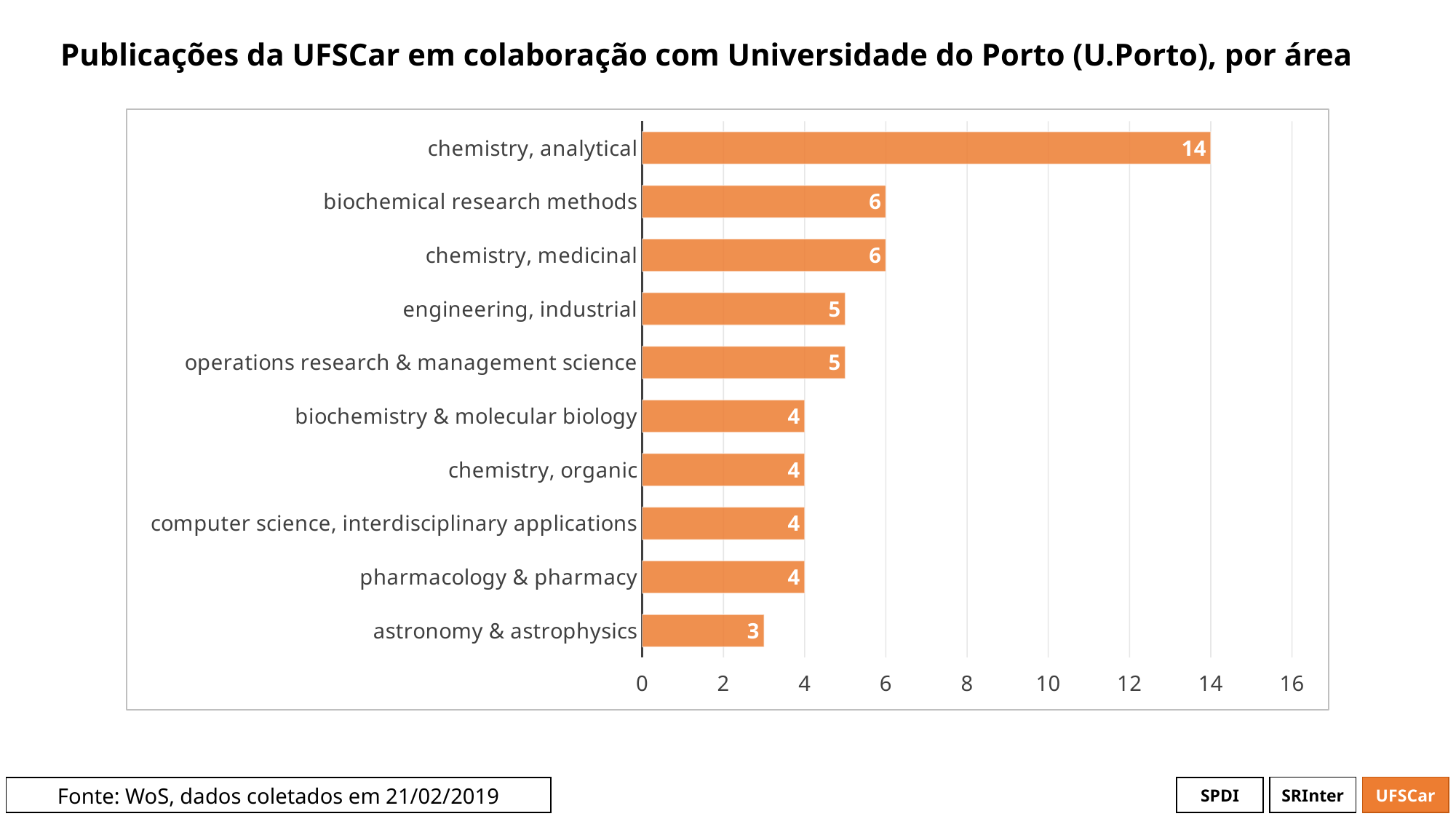
Is the value for chemistry, analytical greater or less than 12? greater What is the value for engineering, industrial? 5 How many areas are shown in the chart? 10 Which area has the lowest number of publications? astronomy & astrophysics What is the value for pharmacology & pharmacy? 4 What is the value for chemistry, analytical? 14 What is the difference between chemistry, analytical and biochemical research methods? 8 What is the value for astronomy & astrophysics? 3 Which is larger, the value for operations research & management science or the value for chemistry, organic? operations research & management science What kind of chart is shown on the slide? bar chart What is the difference between chemistry, medicinal and astronomy & astrophysics? 3 Which area has the highest number of publications? chemistry, analytical